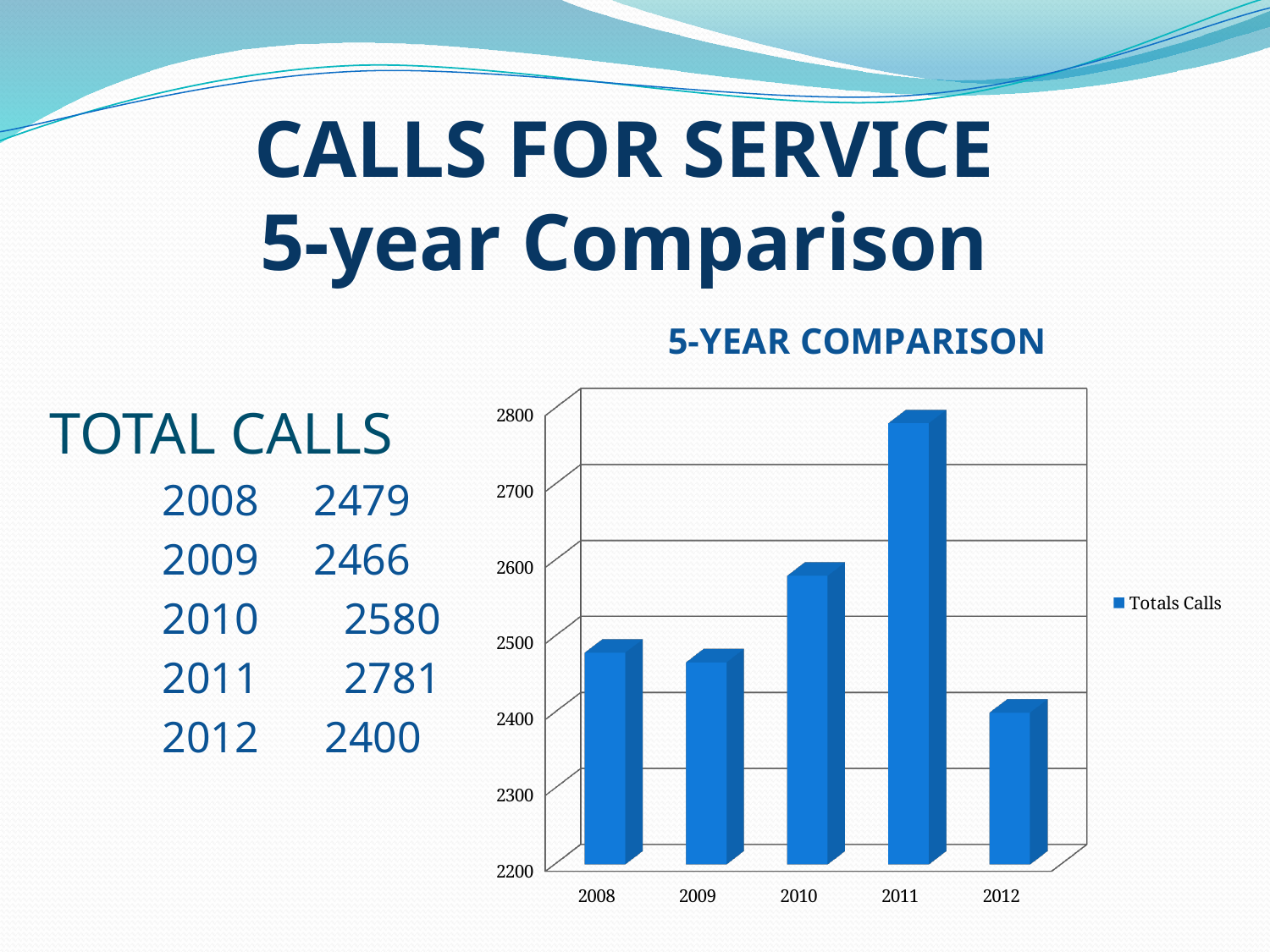
Which year has more total calls, 2008 or 2010? 2010 Which year has the lowest number of total calls in the chart? 2012 How many years are plotted on the x axis of the chart? 5 What is the title of the chart? 5-YEAR COMPARISON What is the total calls value for 2010? 2580 Which year has the highest number of total calls in the chart? 2011 What is the difference in total calls between 2011 and 2012? 381 What kind of chart is shown on the slide? bar chart Is the value for 2010 greater or less than 2500? greater What is the name of the series shown in the chart legend? Totals Calls What is the total calls value for 2011? 2781 How many series does the chart legend list? 1